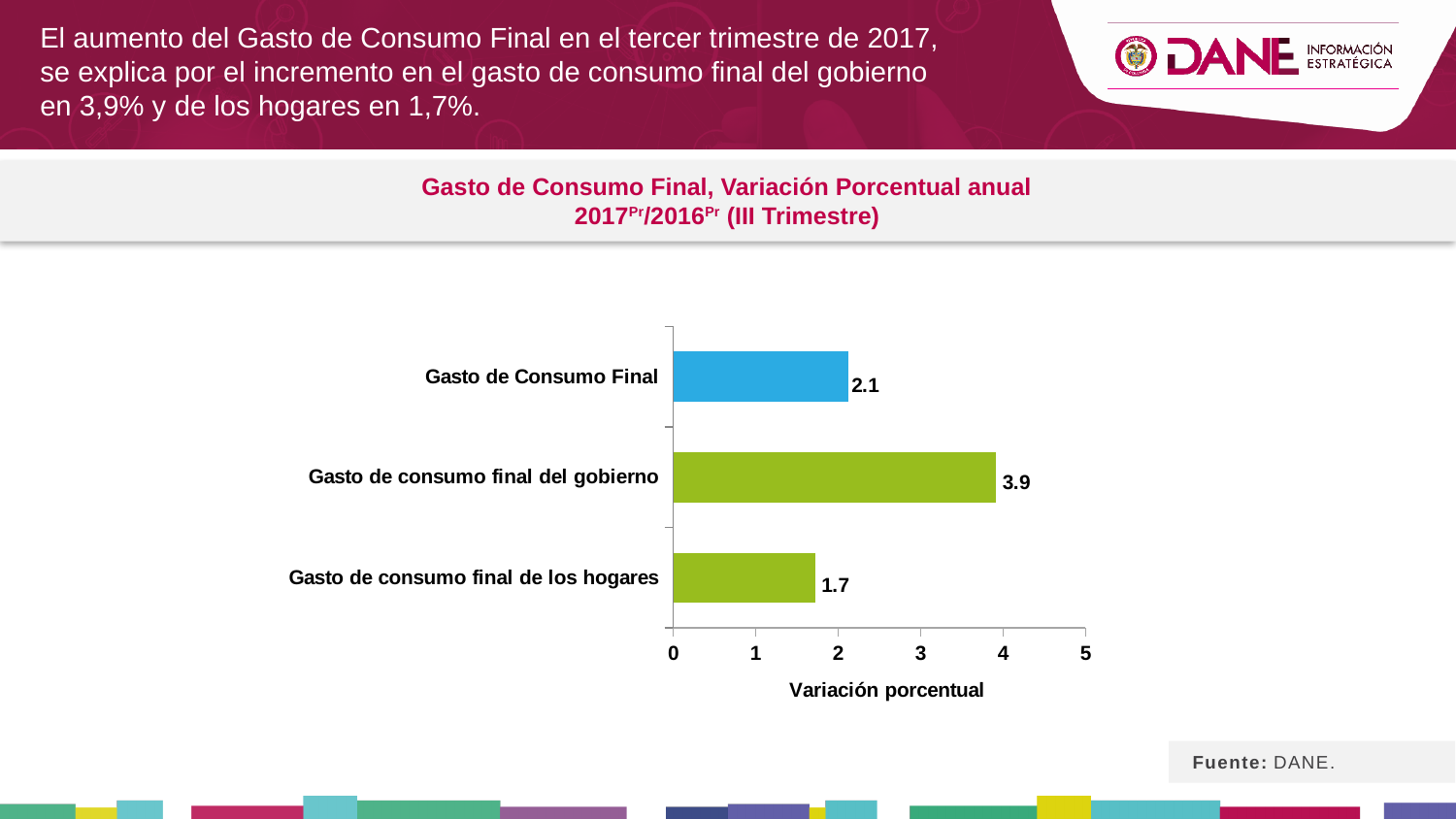
Which category has the highest value? Gasto de consumo final del gobierno What is the difference between the values for Gasto de Consumo Final and Gasto de consumo final de los hogares? 0.4 How many categories are shown in the chart? 3 What kind of chart is shown on the slide? Bar chart What is the value for Gasto de Consumo Final? 2.1 What is the value for Gasto de consumo final de los hogares? 1.7 Is the value for Gasto de consumo final del gobierno greater or less than 3? greater Which category has the lowest value? Gasto de consumo final de los hogares What is the difference between the values for Gasto de consumo final del gobierno and Gasto de consumo final de los hogares? 2.2 What is the value for Gasto de consumo final del gobierno? 3.9 What is the label of the horizontal axis? Variación porcentual Which is larger, the value for Gasto de Consumo Final or the value for Gasto de consumo final del gobierno? Gasto de consumo final del gobierno